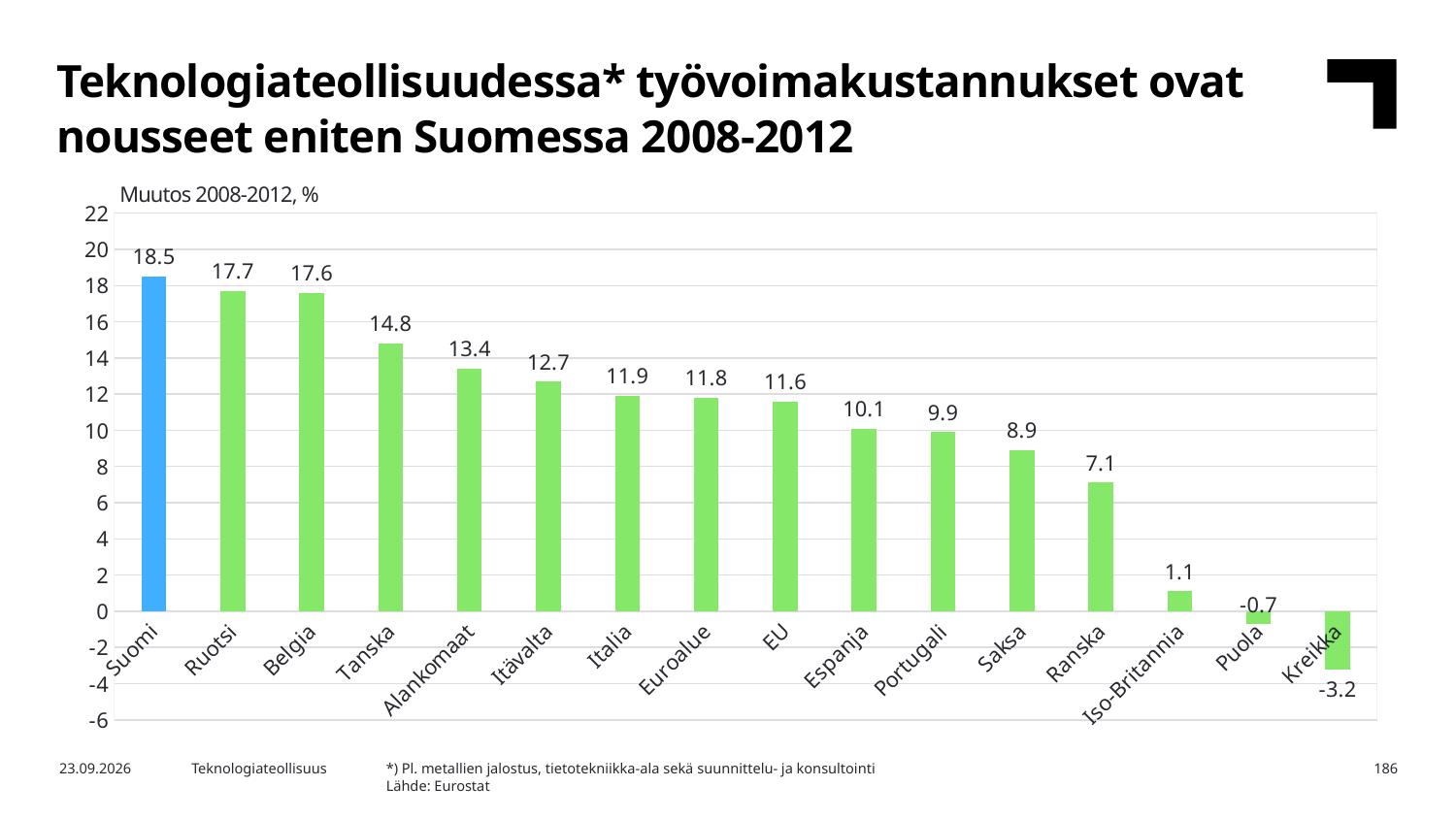
Do the values rise or fall from left to right along the x axis? fall What is the value for Alankomaat? 13.4 What is the difference between the values for Suomi and Ruotsi? 0.8 What is the value for Kreikka? -3.2 Which country has the highest value? Suomi What kind of chart is shown on the slide? bar chart What is the value for Suomi? 18.5 Which country has the lowest value? Kreikka Which is larger, the value for Tanska or the value for Itävalta? Tanska Is the value for Saksa greater or less than 10? less How many categories are shown on the x axis? 16 Which bar is coloured differently from the others? Suomi